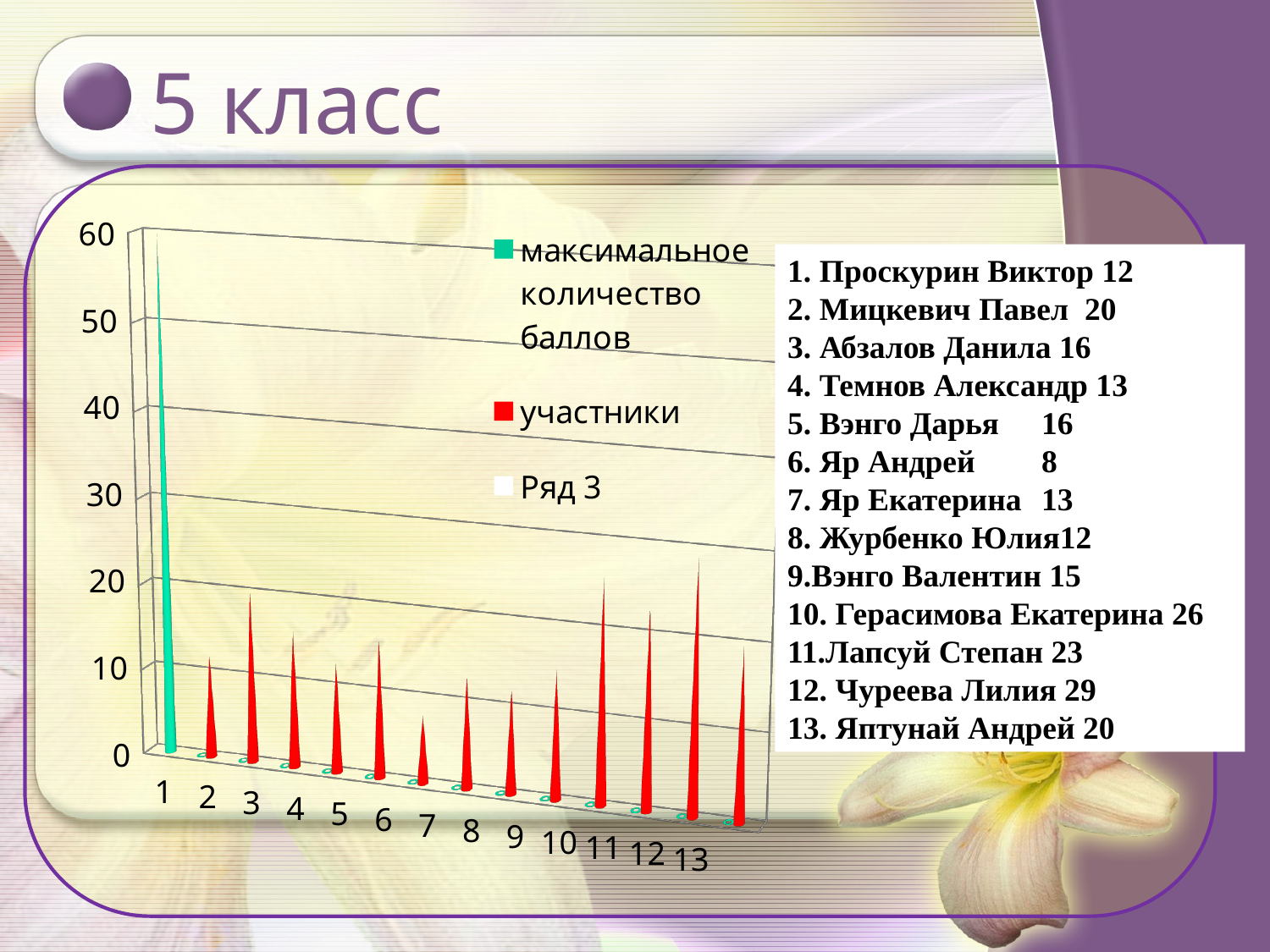
Which category has the tallest red 'участники' bar? 13 What colour represents the 'участники' series in the chart? red What kind of chart is shown on the slide? bar chart Is the 'участники' value for category 12 greater or less than 20? greater What is the name of the first series listed in the chart legend? максимальное количество баллов Which is larger, the 'участники' value for category 10 or for category 7? category 10 How many series does the chart legend list? 3 Is the 'максимальное количество баллов' value for category 1 greater or less than 50? greater Which category has the shortest red 'участники' bar? 7